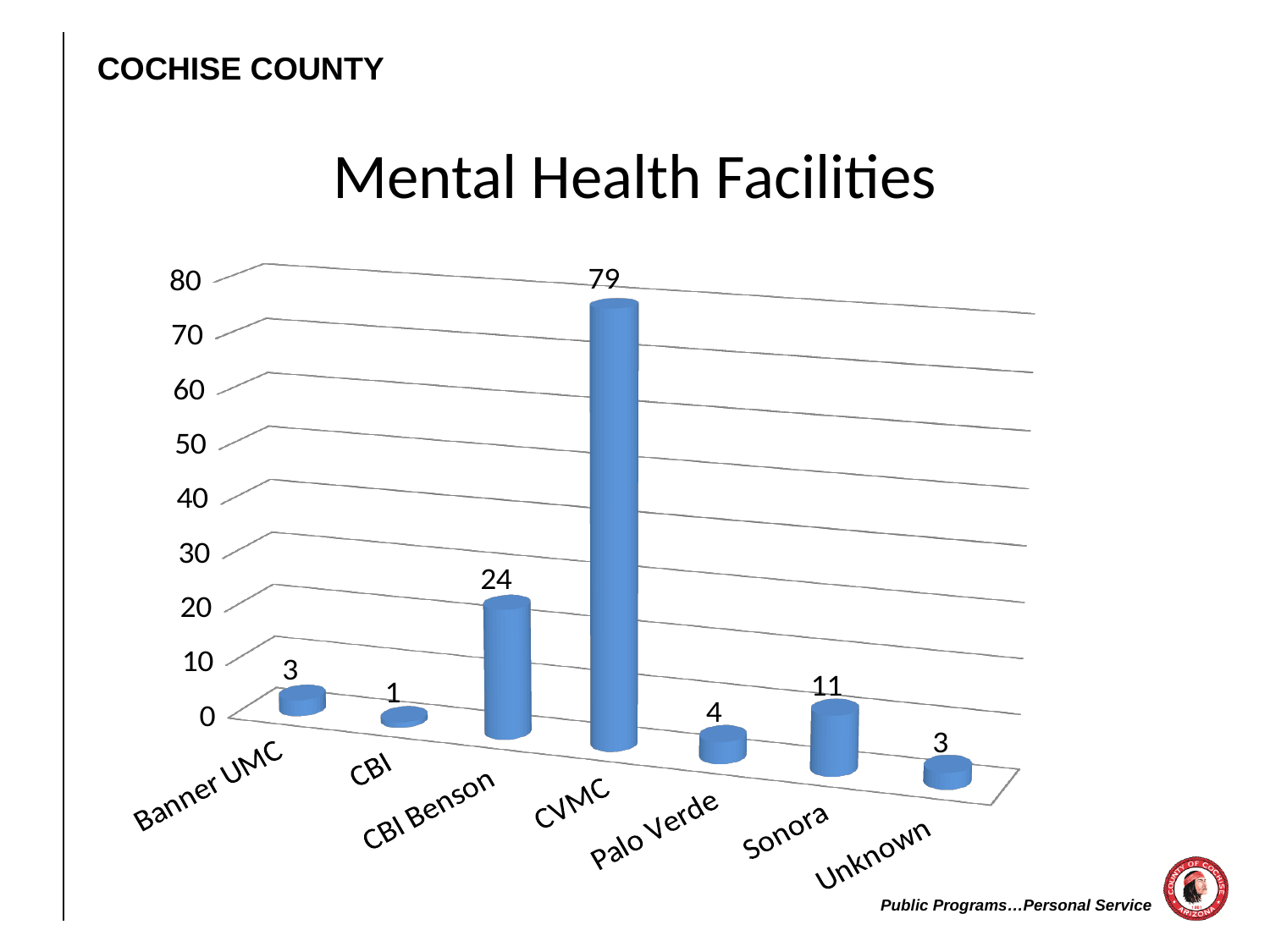
What is the title of the chart? Mental Health Facilities Which is larger, the value for Sonora or the value for Palo Verde? Sonora What is the value for CBI Benson? 24 What is the value for CVMC? 79 What is the value for Sonora? 11 What is the difference between the values for CVMC and CBI Benson? 55 Which facility has the lowest value? CBI What kind of chart is this? bar chart Which facility has the highest value? CVMC Is the value for CVMC greater or less than 70? greater How many facilities are shown on the x axis? 7 What is the value for Palo Verde? 4